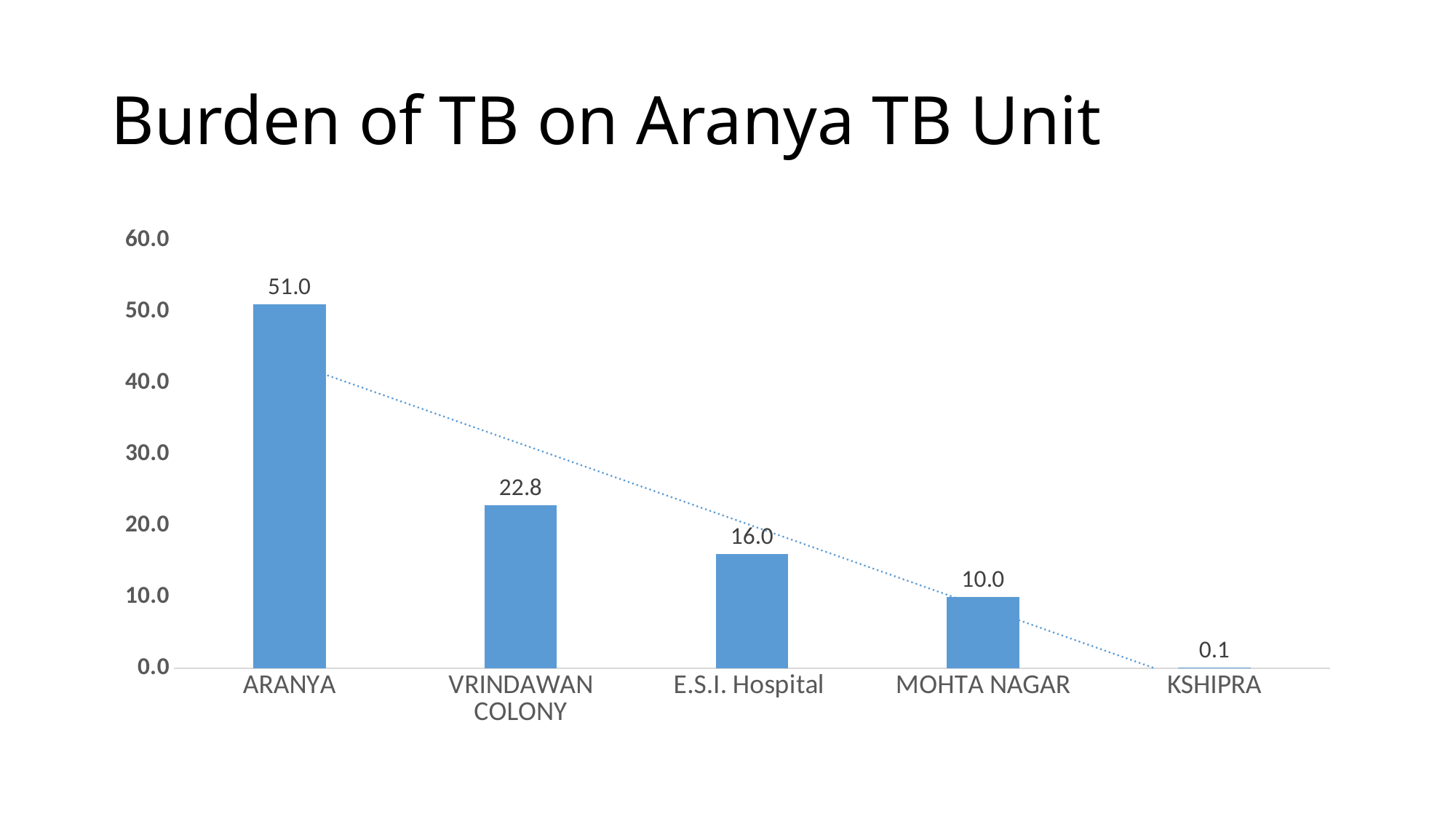
What is the value for KSHIPRA? 0.1 What is the difference between the values for ARANYA and VRINDAWAN COLONY? 28.2 Which category has the lowest value? KSHIPRA Do the values rise or fall from left to right along the x axis? fall Which is larger, the value for E.S.I. Hospital or the value for MOHTA NAGAR? E.S.I. Hospital What is the value for VRINDAWAN COLONY? 22.8 Is the value for MOHTA NAGAR greater or less than 20.0? less What kind of chart is shown on the slide? bar chart Which category has the highest value? ARANYA What is the value for ARANYA? 51.0 How many categories are shown on the x axis? 5 What is the value for E.S.I. Hospital? 16.0